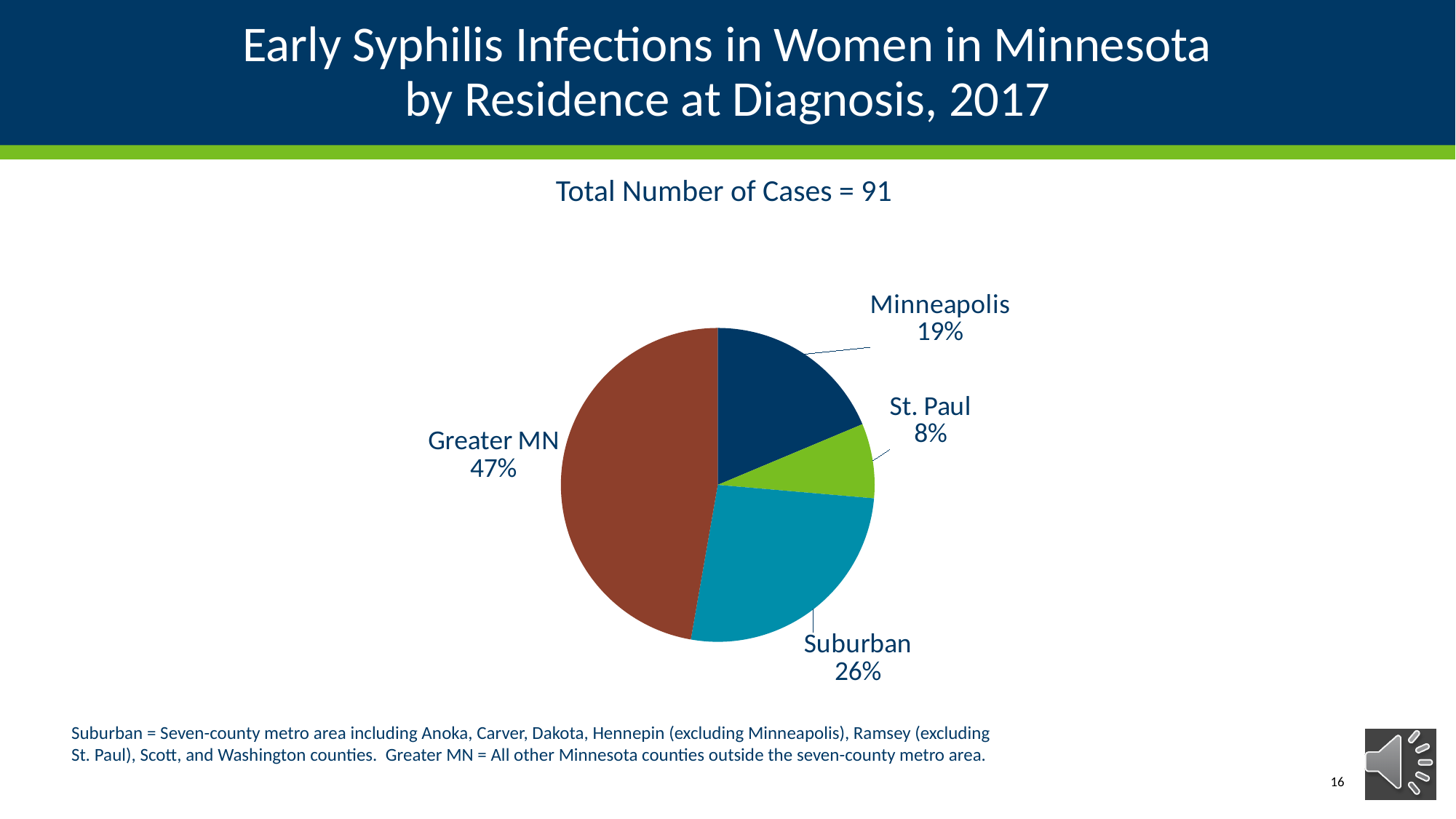
Which has a larger share of cases, Suburban or Minneapolis? Suburban What percentage of cases is attributed to St. Paul? 8% What is the difference in percentage points between Greater MN and Suburban? 21 How many residence categories are shown in the pie chart? 4 Which residence category has the largest share of cases? Greater MN What is the total number of cases stated on the slide? 91 What percentage of early syphilis infections in women were among residents of Greater MN? 47% What type of chart is shown on the slide? Pie chart What percentage of cases is shown for the Suburban category? 26% What share of cases is shown for Minneapolis? 19% What is the difference in percentage points between Minneapolis and St. Paul? 11 Which residence category has the smallest share of cases? St. Paul